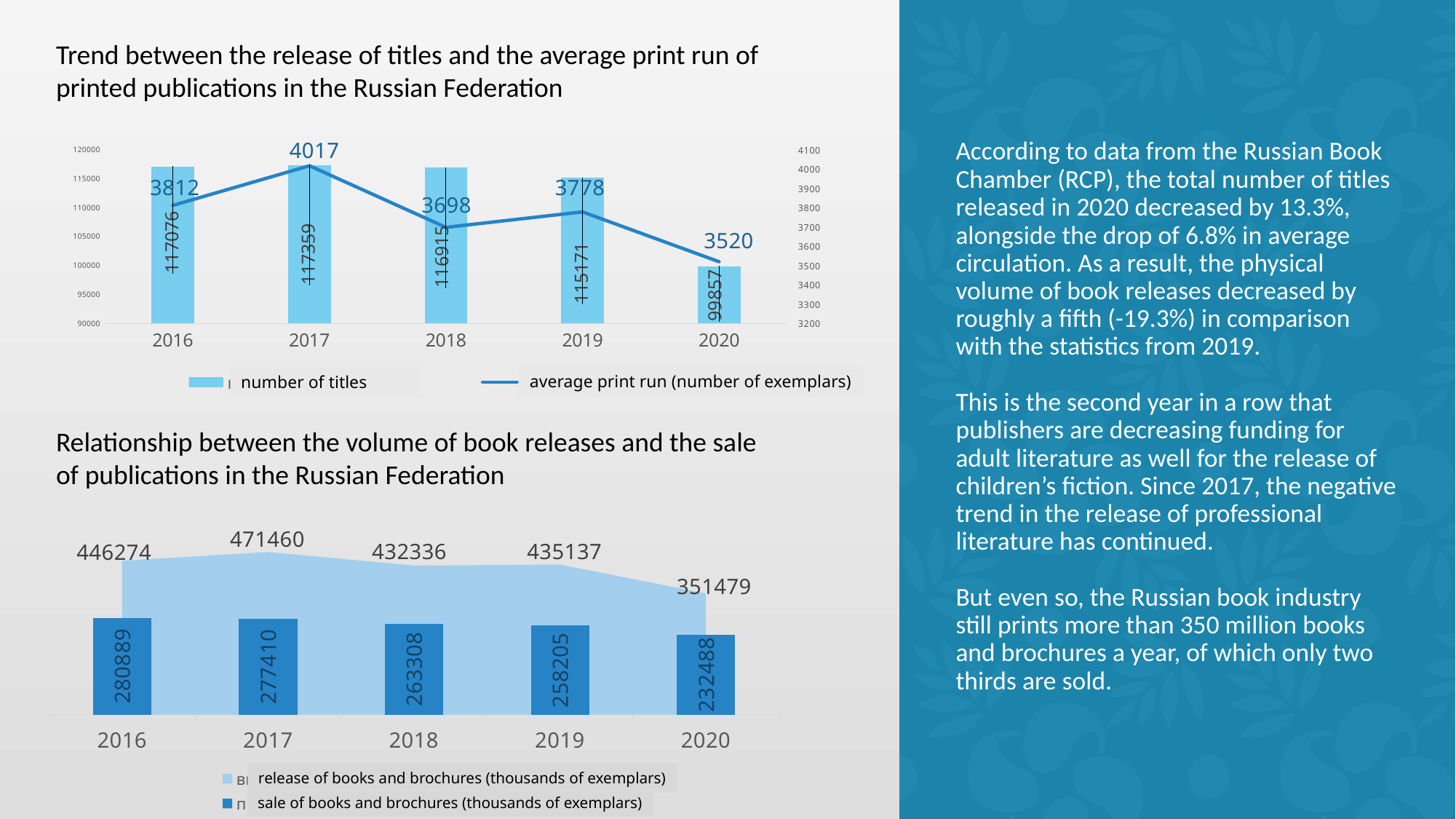
In the bottom chart (Relationship between the volume of book releases and the sale of publications), which year has the lowest sale of books and brochures? 2020 In the top chart (Trend between the release of titles and the average print run), how many series does the legend list? 2 In the bottom chart (Relationship between the volume of book releases and the sale of publications), what is the difference between the release and the sale of books and brochures in 2020? 118991 In the bottom chart (Relationship between the volume of book releases and the sale of publications), is the sale of books and brochures larger in 2016 or in 2017? 2016 In the bottom chart (Relationship between the volume of book releases and the sale of publications), what is the release of books and brochures in 2017? 471460 In the bottom chart (Relationship between the volume of book releases and the sale of publications), how many years are shown on the x axis? 5 In the top chart (Trend between the release of titles and the average print run), which year has the highest average print run? 2017 In the top chart (Trend between the release of titles and the average print run), what is the number of titles in 2020? 99857 In the top chart (Trend between the release of titles and the average print run), what is the difference between the average print run in 2017 and in 2020? 497 In the bottom chart (Relationship between the volume of book releases and the sale of publications), what is the sale of books and brochures in 2019? 258205 In the top chart (Trend between the release of titles and the average print run), what is the average print run in 2017? 4017 In the top chart (Trend between the release of titles and the average print run), which year has the lowest number of titles? 2020